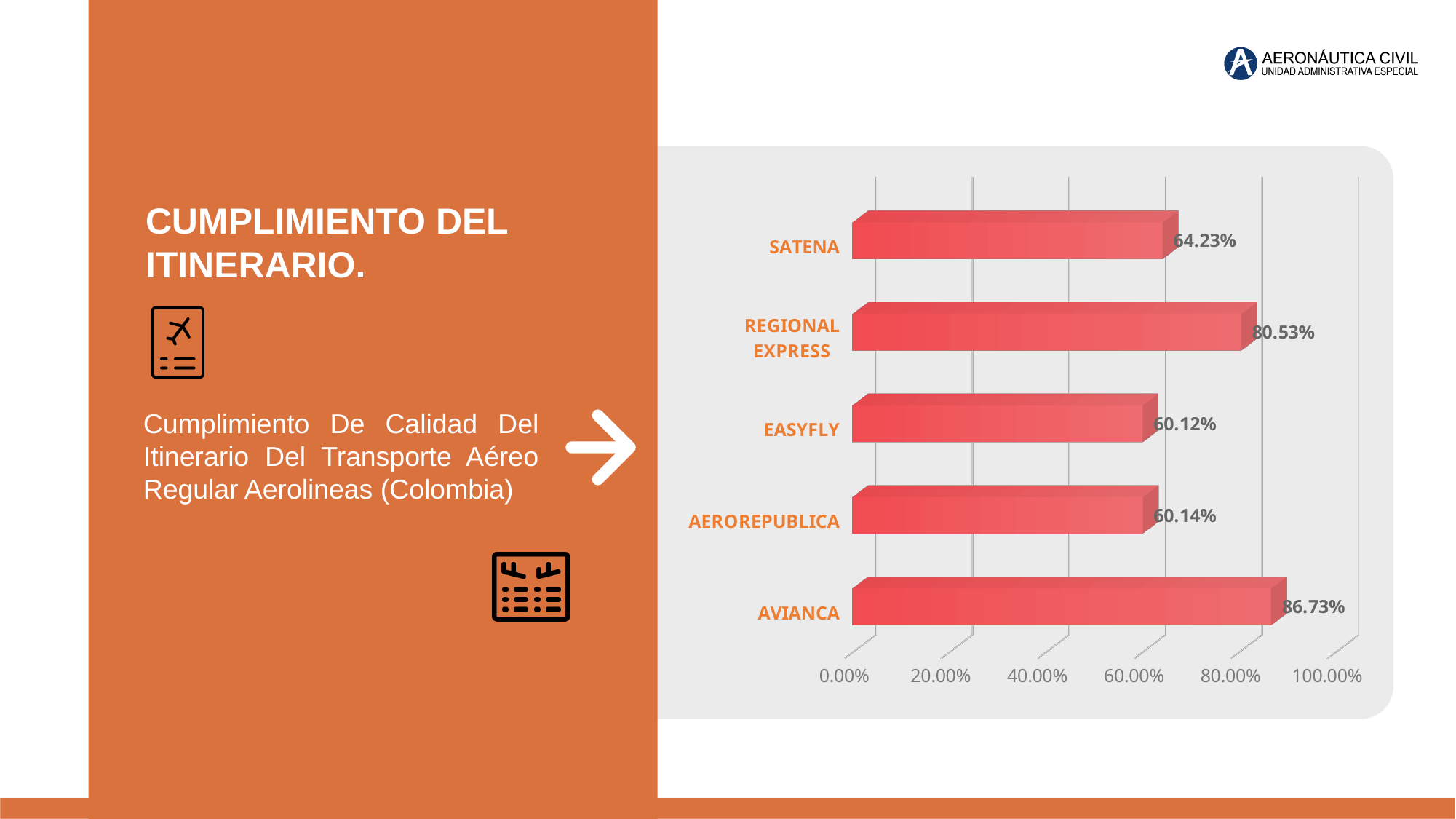
Is the value for AVIANCA greater or less than 80.00%? greater What kind of chart is shown on the slide? bar chart What is the difference between the values for AVIANCA and REGIONAL EXPRESS? 6.20% What is the value for REGIONAL EXPRESS? 80.53% What is the value for SATENA? 64.23% Which is larger, the value for SATENA or the value for EASYFLY? SATENA What is the value for AEROREPUBLICA? 60.14% How many airlines are shown in the chart? 5 What is the value for EASYFLY? 60.12% What is the value for AVIANCA? 86.73% Which airline has the highest value? AVIANCA What is the difference between the values for REGIONAL EXPRESS and SATENA? 16.30%